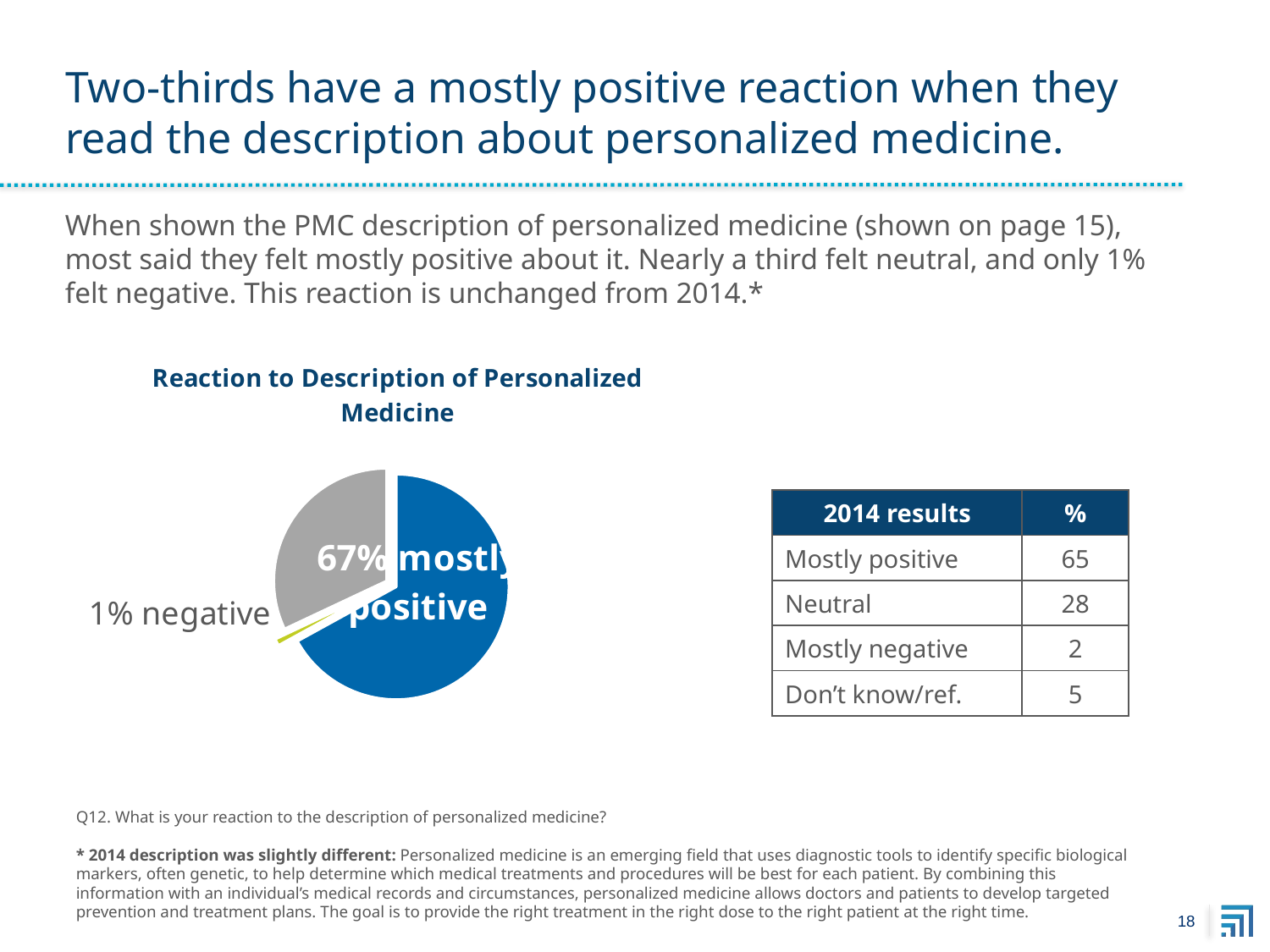
How many slices does the pie chart have? 3 Which reaction has the largest slice in the pie chart? Mostly positive Which reaction has the smallest slice in the pie chart? Negative What share of the pie chart is labeled as negative? 1% What is the title of the pie chart? Reaction to Description of Personalized Medicine By how many percentage points does the mostly positive slice exceed the negative slice in the pie chart? 66 percentage points What share of the pie chart is labeled as mostly positive? 67% What colour is the mostly positive slice in the pie chart? Blue What kind of chart is shown on the slide? Pie chart Is the mostly positive slice more or less than half of the pie chart? More Which slice is larger in the pie chart: mostly positive or negative? Mostly positive